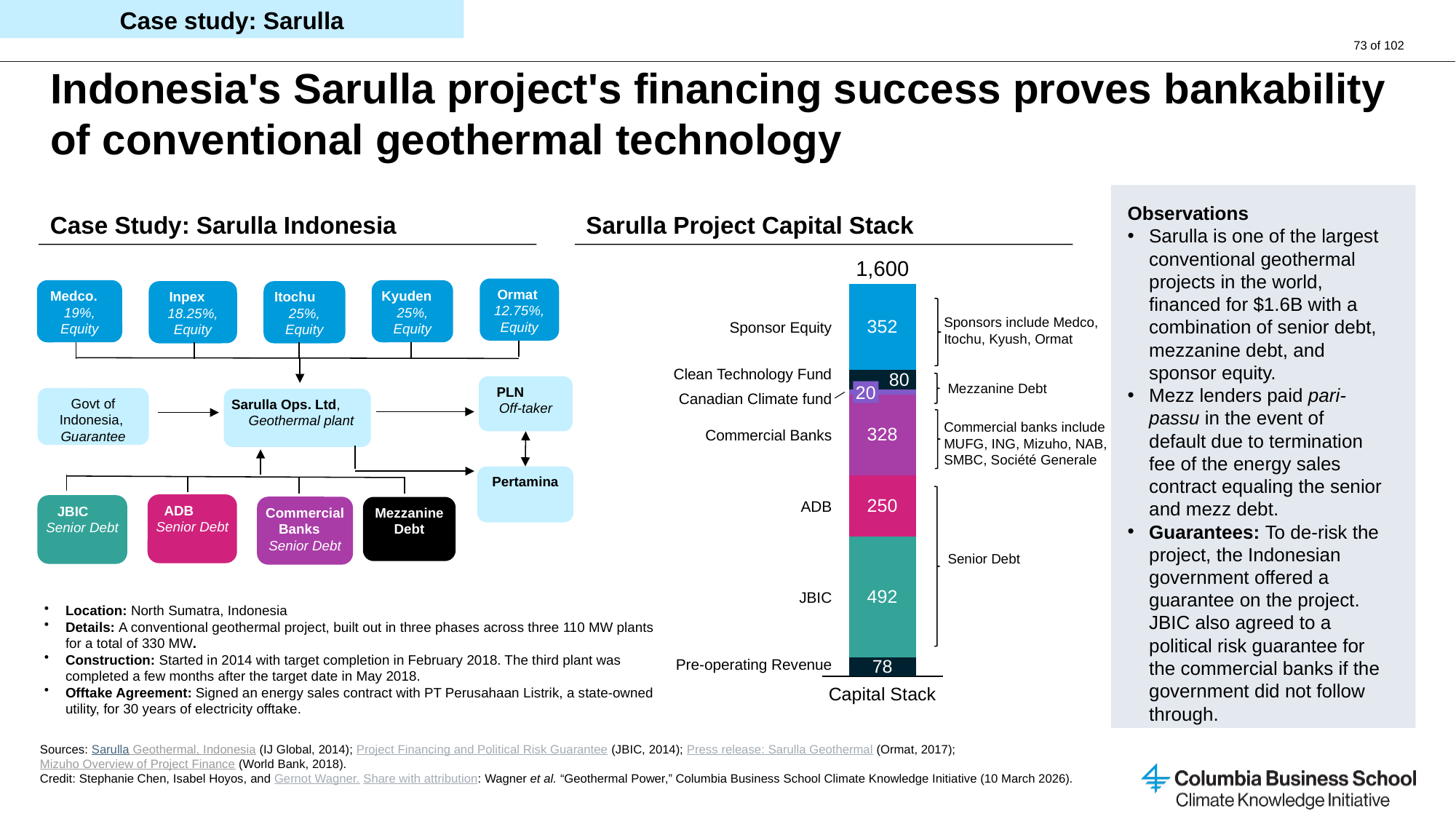
In the Sarulla Project Capital Stack chart, what is the value for Sponsor Equity? 352 In the Sarulla Project Capital Stack chart, which segment has the smallest value? Canadian Climate fund In the Sarulla Project Capital Stack chart, what is the value for the Canadian Climate fund? 20 What kind of chart is the Sarulla Project Capital Stack? Stacked bar chart In the Sarulla Project Capital Stack chart, what is the total of the stacked bar? 1,600 In the Sarulla Project Capital Stack chart, which segment has the largest value? JBIC In the Sarulla Project Capital Stack chart, what is the difference between the JBIC value and the ADB value? 242 What is the title of the chart on the slide? Sarulla Project Capital Stack In the Sarulla Project Capital Stack chart, which is larger: Sponsor Equity or Commercial Banks? Sponsor Equity In the Sarulla Project Capital Stack chart, what is the value for JBIC? 492 In the Sarulla Project Capital Stack chart, what is the value for Commercial Banks? 328 In the Sarulla Project Capital Stack chart, what is the value for Pre-operating Revenue? 78